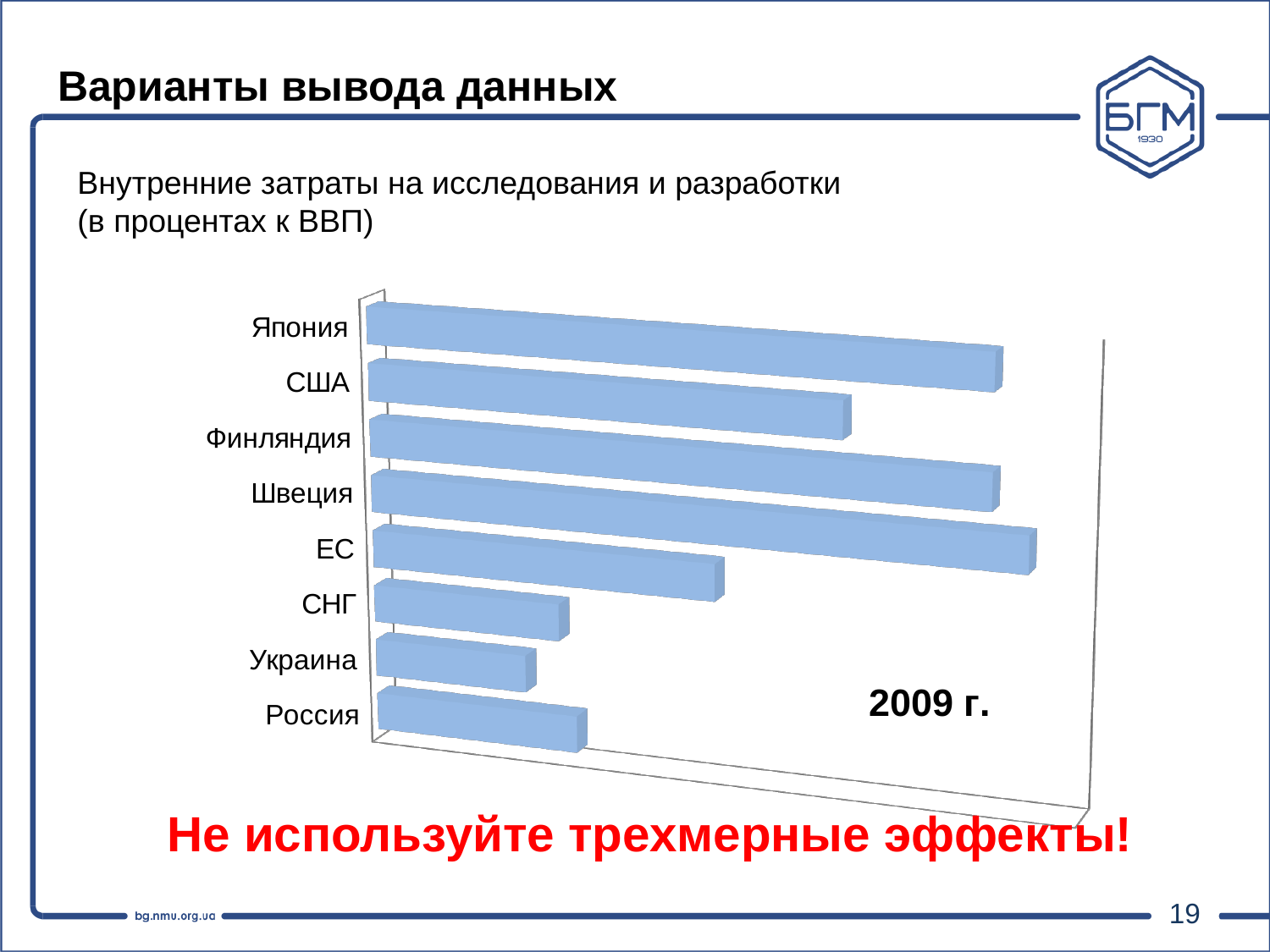
What kind of chart is shown on the slide? Bar chart Which has the longer bar on the chart, Япония or США? Япония Which has the longer bar on the chart, Россия or Финляндия? Финляндия Which has the longer bar on the chart, Швеция or СНГ? Швеция How many countries or regions are listed on the chart? 8 What is the title of the chart on the slide? Внутренние затраты на исследования и разработки (в процентах к ВВП) What year is indicated on the chart? 2009 г.